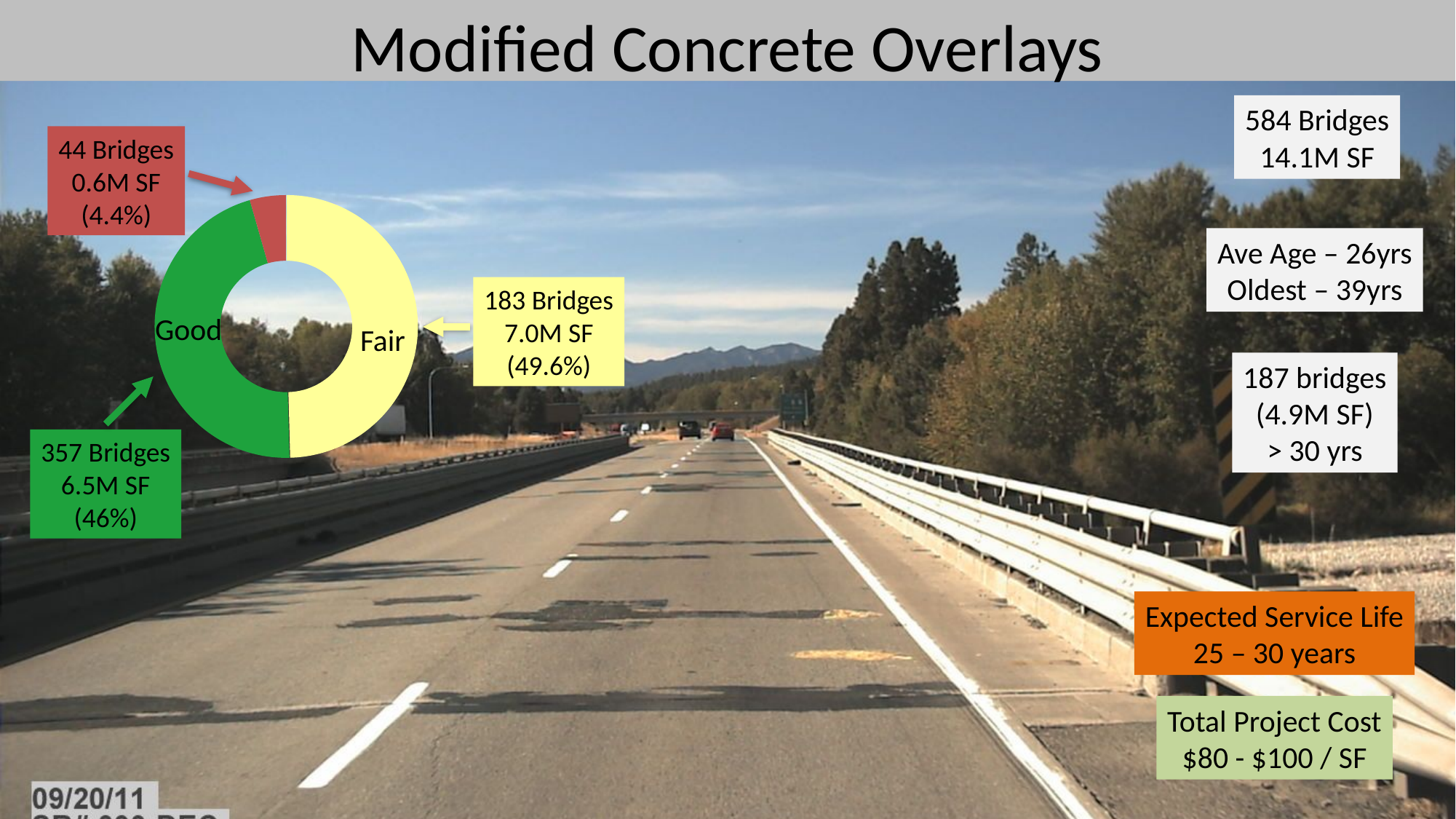
Which has more square footage, the Good slice or the Fair slice? Fair What percentage share does the Fair slice have? 49.6% Which slice of the chart has the smallest share? the red slice (44 Bridges, 4.4%) Which slice of the chart has the largest share? Fair How many more bridges are in the Good slice than in the Fair slice? 174 What square footage is labelled for the Fair slice? 7.0M SF What percentage share does the red slice of the chart have? 4.4% What kind of chart is shown on the slide? pie chart (donut) How many slices does the donut chart have? 3 What colour is the Good slice of the chart? green What is the total number of bridges across all three slices of the chart? 584 How many bridges are in the Good slice of the chart? 357 Bridges